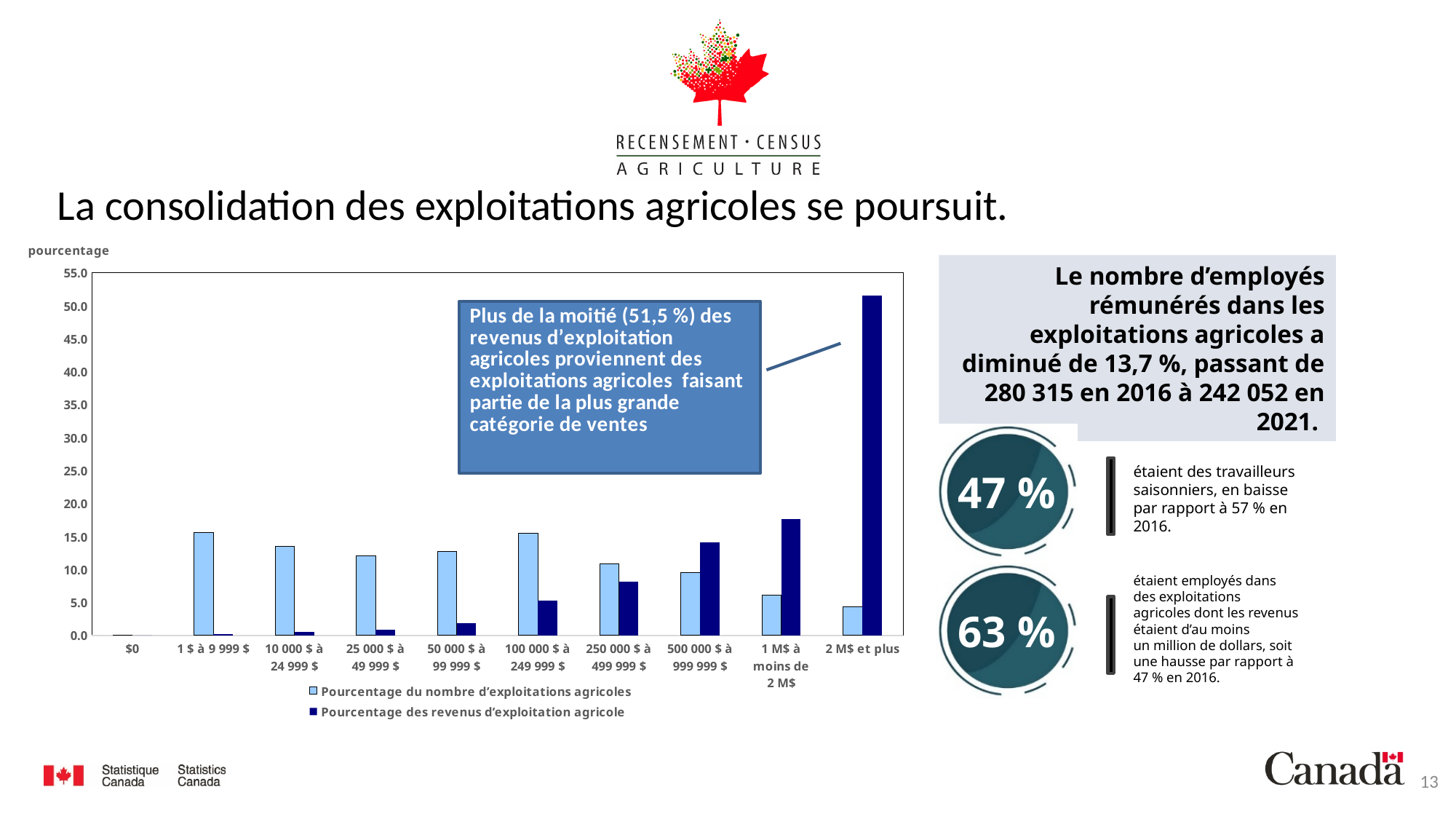
Is the value for 'Pourcentage des revenus d'exploitation agricole' in the '2 M$ et plus' category greater or less than 50? greater Is the value for 'Pourcentage du nombre d'exploitations agricoles' in the '2 M$ et plus' category greater or less than 10? less According to the callout on the chart, what percentage of farm operating revenues comes from the largest sales category (2 M$ et plus)? 51,5 % In the '25 000 $ à 49 999 $' category, which series has the larger value? Pourcentage du nombre d'exploitations agricoles Which sales category has the highest value for 'Pourcentage des revenus d'exploitation agricole'? 2 M$ et plus What kind of chart is shown on the slide? bar chart In the '500 000 $ à 999 999 $' category, which series has the larger value? Pourcentage des revenus d'exploitation agricole Do the values for 'Pourcentage des revenus d'exploitation agricole' generally rise or fall as the sales categories increase along the x axis? rise Is the value for 'Pourcentage des revenus d'exploitation agricole' in the '1 M$ à moins de 2 M$' category greater or less than 15? greater How many sales categories are shown along the x axis of the chart? 10 Which sales category has the lowest value for 'Pourcentage du nombre d'exploitations agricoles'? $0 How many series does the chart's legend list? 2